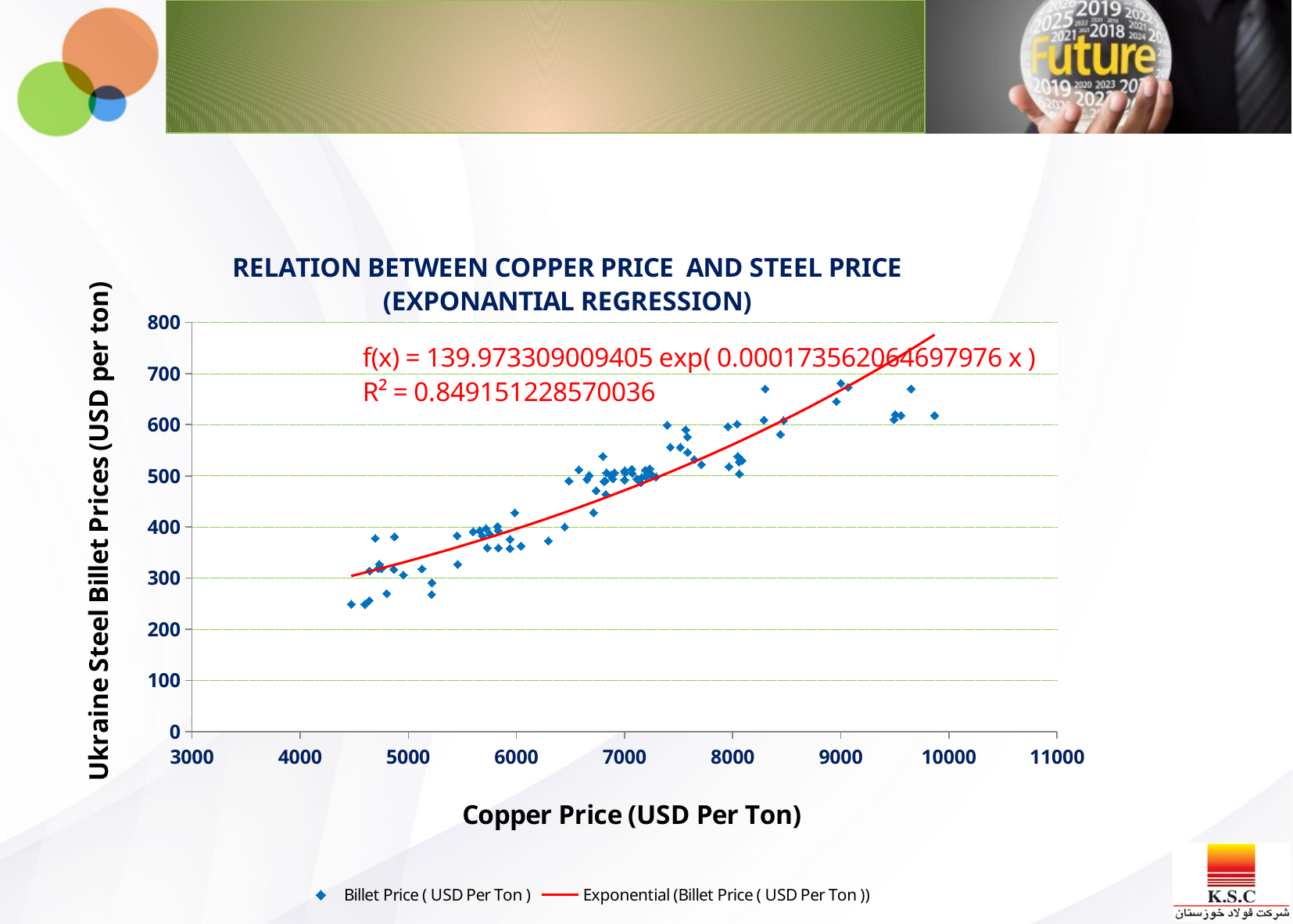
What is the exponent coefficient multiplying x in the fitted equation f(x) shown on the chart? 0.000173562064697976 What R² value is printed on the chart for the exponential regression? 0.849151228570036 What is the title of the chart? RELATION BETWEEN COPPER PRICE AND STEEL PRICE (EXPONANTIAL REGRESSION) What kind of chart is shown on the slide? Scatter chart How many entries does the chart legend list? 2 What is the coefficient in front of the exponential term in the fitted equation f(x) shown on the chart? 139.973309009405 Is the highest plotted billet price greater or less than 600? greater Do the billet prices generally rise or fall as the copper price increases along the x axis? Rise Is the lowest plotted billet price greater or less than 300? less What is the maximum value shown on the x axis (Copper Price)? 11000 What are the two entries listed in the chart legend? Billet Price ( USD Per Ton ) and Exponential (Billet Price ( USD Per Ton )) What is the maximum value shown on the y axis (Ukraine Steel Billet Prices)? 800